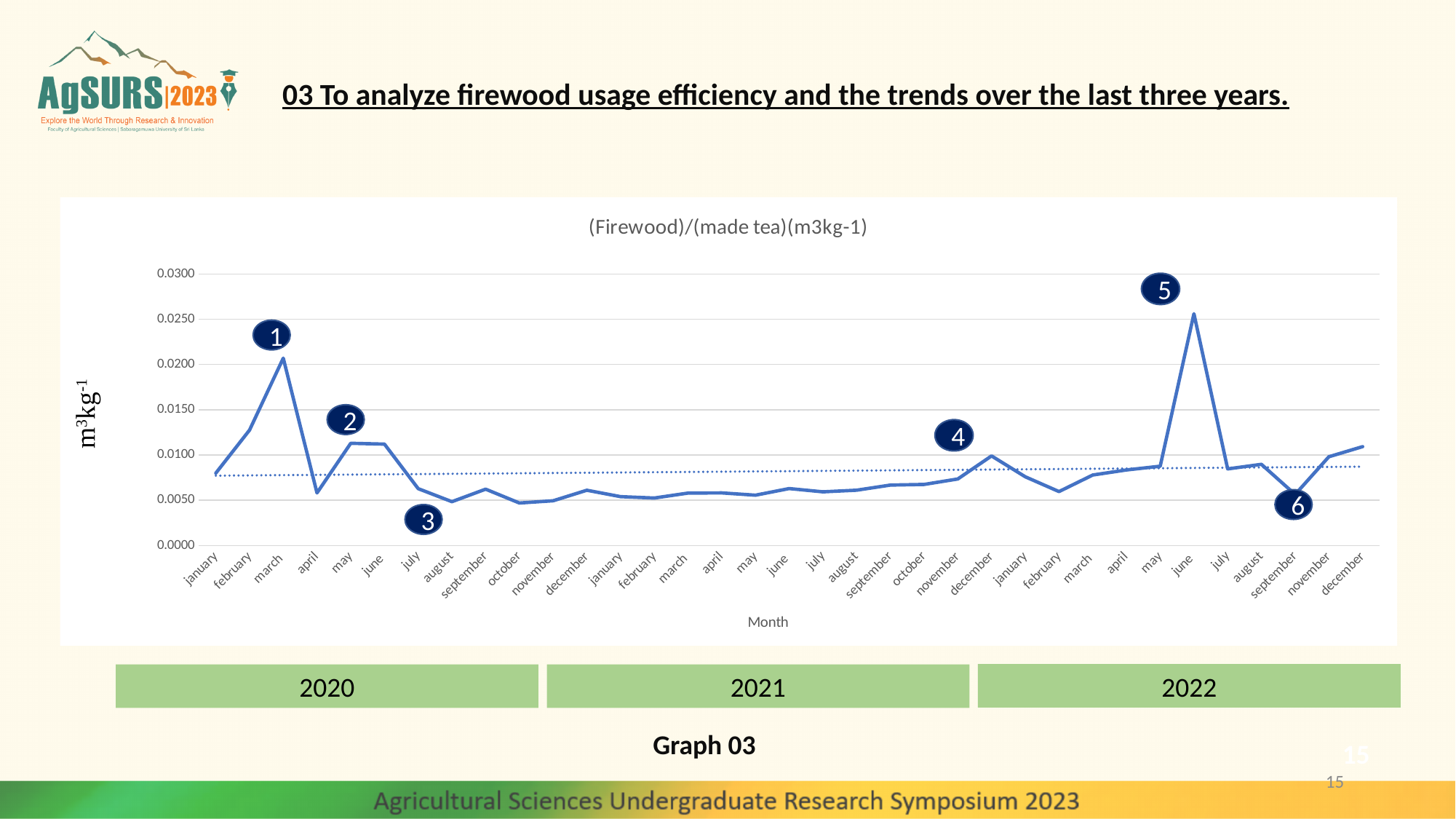
How many monthly data points are plotted on the chart? 35 Is the value for June 2022 greater or less than 0.0200? greater Is the value for April 2020 greater or less than 0.0100? less Which is larger, the value for May 2020 or the value for December 2021? May 2020 Does the value rise or fall from March 2020 to April 2020? fall What is the title of the chart? (Firewood)/(made tea)(m3kg-1) Which month has the highest value on the chart? June 2022 What kind of chart is shown on the slide? line chart Is the value for March 2020 greater or less than 0.0150? greater What is the label on the x axis of the chart? Month Which is larger, the value for March 2020 or the value for June 2022? June 2022